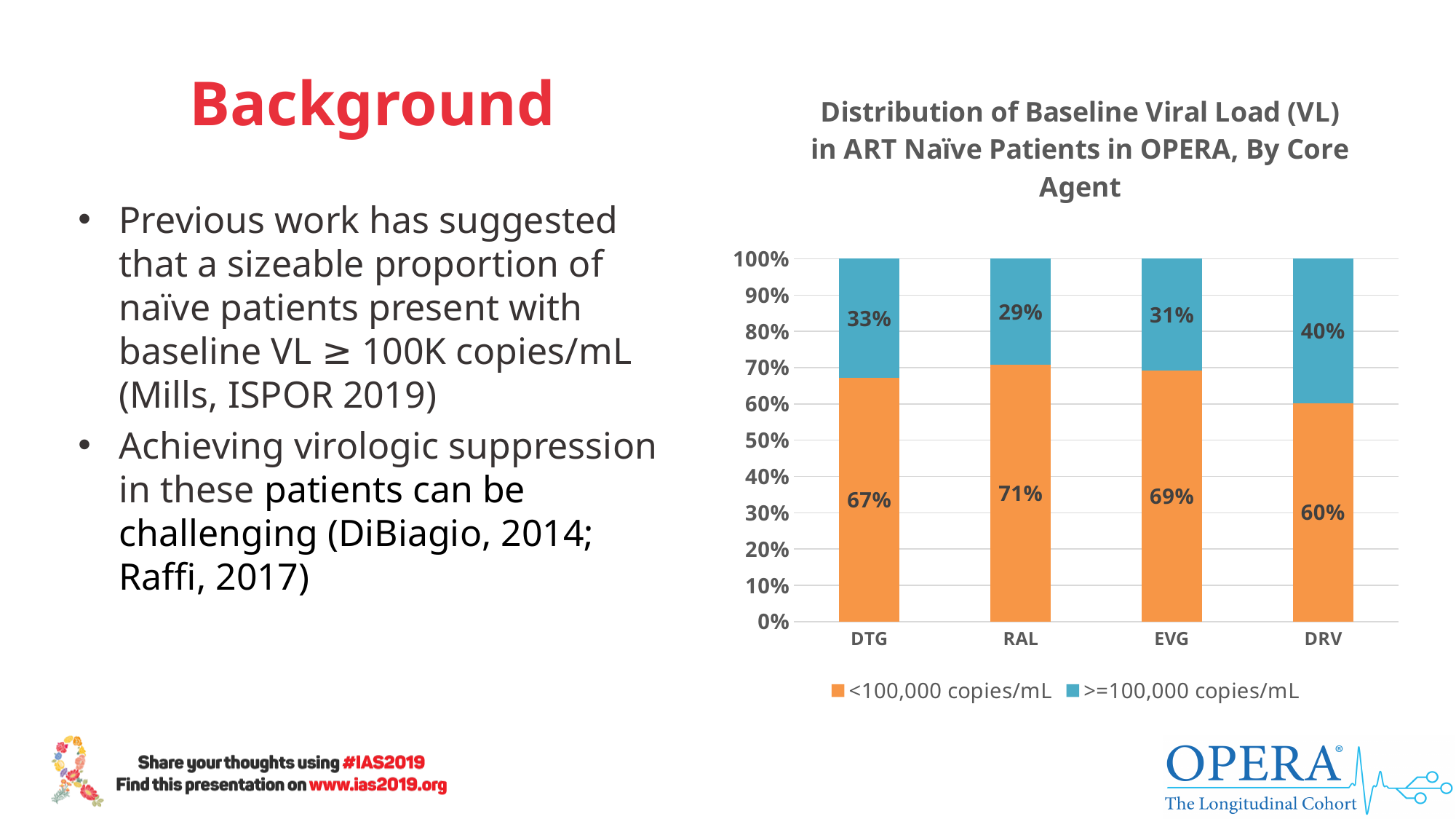
What kind of chart is shown on the slide? Stacked bar chart What is the value for RAL in the >=100,000 copies/mL series? 29% What percentage of DRV patients had a baseline VL of >=100,000 copies/mL? 40% What is the difference between the <100,000 copies/mL values for RAL and DRV? 11% Which is larger: the >=100,000 copies/mL value for DTG or for EVG? DTG What colour represents the >=100,000 copies/mL series? Blue Which core agent has the lowest proportion of patients with baseline VL <100,000 copies/mL? DRV Which core agent has the highest proportion of patients with baseline VL <100,000 copies/mL? RAL Which core agent has the highest proportion of patients with baseline VL >=100,000 copies/mL? DRV How many series does the legend list? 2 How many core agents are shown on the x axis? 4 What percentage of DTG patients had a baseline VL of <100,000 copies/mL? 67%